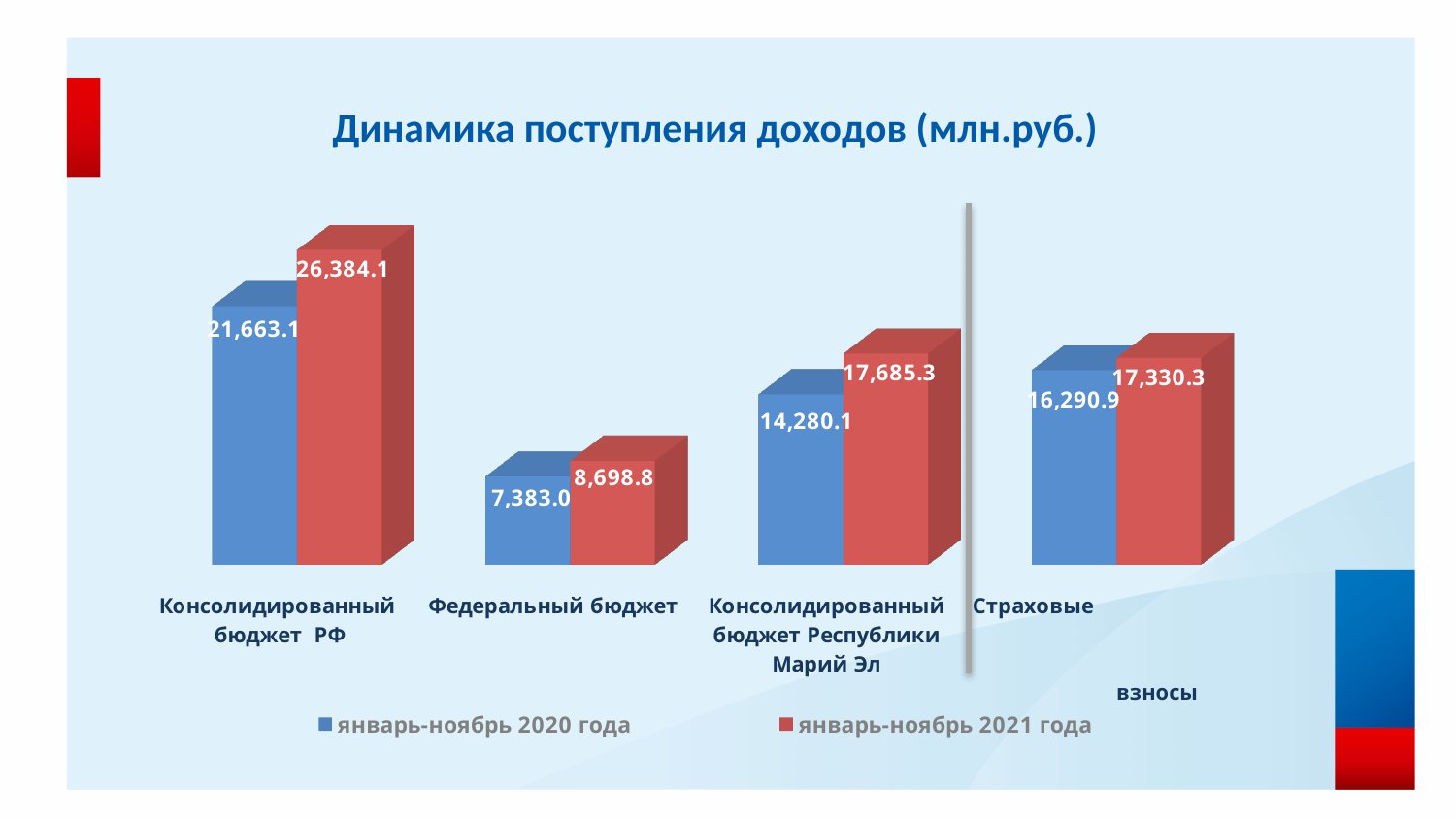
What is the value for Федеральный бюджет in the январь-ноябрь 2020 года series? 7,383.0 Which category has the highest value in the январь-ноябрь 2021 года series? Консолидированный бюджет РФ What is the value for Консолидированный бюджет Республики Марий Эл in the январь-ноябрь 2020 года series? 14,280.1 Which category has the lowest value in the январь-ноябрь 2020 года series? Федеральный бюджет How many categories are shown on the x axis? 4 What is the difference between the 2021 and 2020 values for Консолидированный бюджет РФ? 4,721.0 Which is larger: the январь-ноябрь 2020 года value for Страховые взносы or the январь-ноябрь 2020 года value for Консолидированный бюджет Республики Марий Эл? Страховые взносы What is the value for Страховые взносы in the январь-ноябрь 2021 года series? 17,330.3 What is the difference between the 2021 and 2020 values for Консолидированный бюджет Республики Марий Эл? 3,405.2 What kind of chart is shown on the slide? Bar chart How many series does the legend list? 2 What is the value for Консолидированный бюджет РФ in the январь-ноябрь 2021 года series? 26,384.1